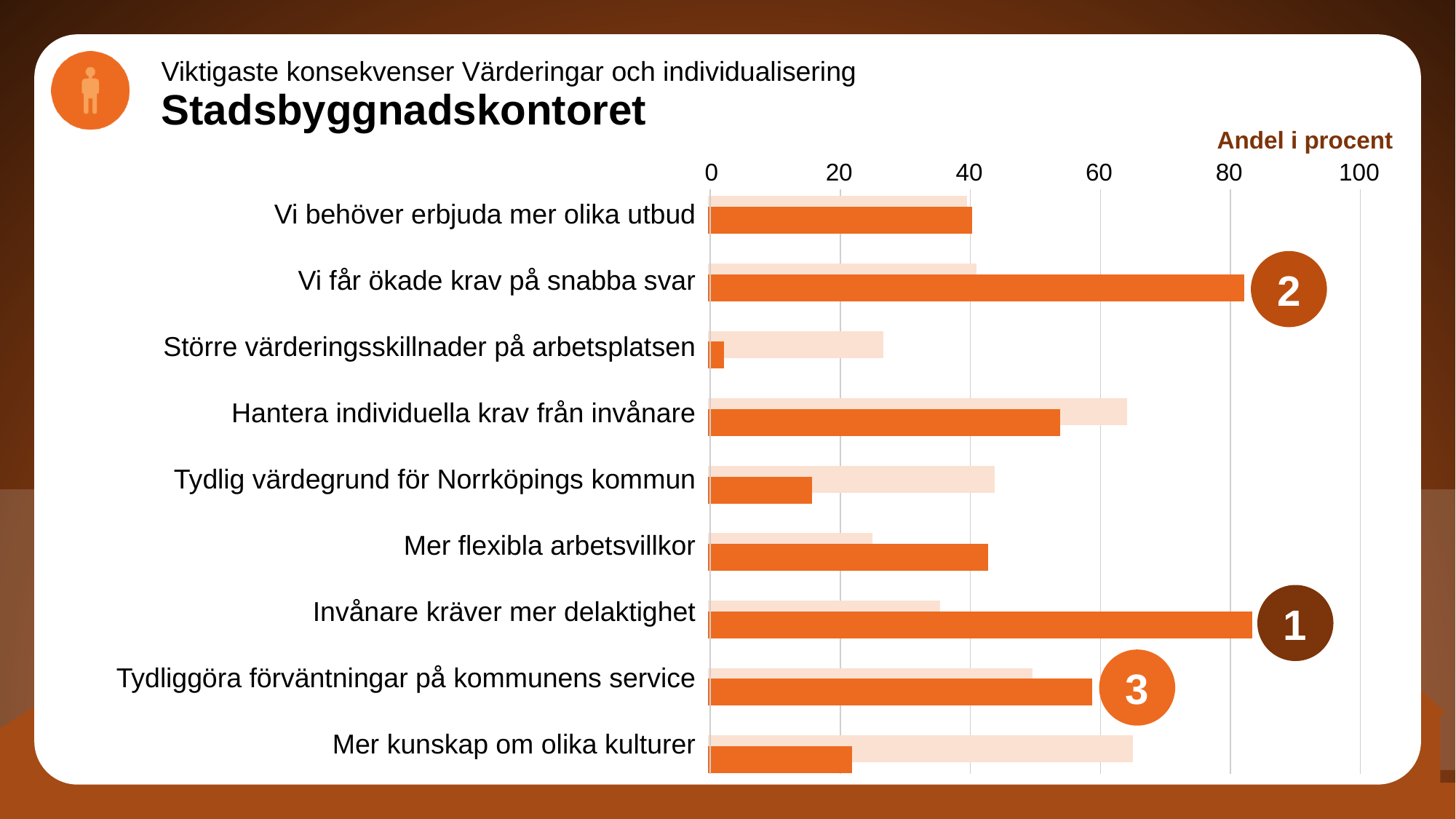
Which has the longer dark orange bar: "Vi får ökade krav på snabba svar" or "Vi behöver erbjuda mer olika utbud"? Vi får ökade krav på snabba svar What number is shown in the circle next to the bar for "Invånare kräver mer delaktighet"? 1 Is the dark orange bar for "Vi får ökade krav på snabba svar" greater or less than 60? greater How many categories are listed on the chart? 9 Is the dark orange bar for "Mer kunskap om olika kulturer" greater or less than 40? less Which category has the shortest dark orange bar? Större värderingsskillnader på arbetsplatsen Which has the longer dark orange bar: "Mer flexibla arbetsvillkor" or "Tydlig värdegrund för Norrköpings kommun"? Mer flexibla arbetsvillkor Is the dark orange bar for "Tydlig värdegrund för Norrköpings kommun" greater or less than 20? less What label is shown above the horizontal axis of the chart? Andel i procent What kind of chart is shown on the slide? Bar chart